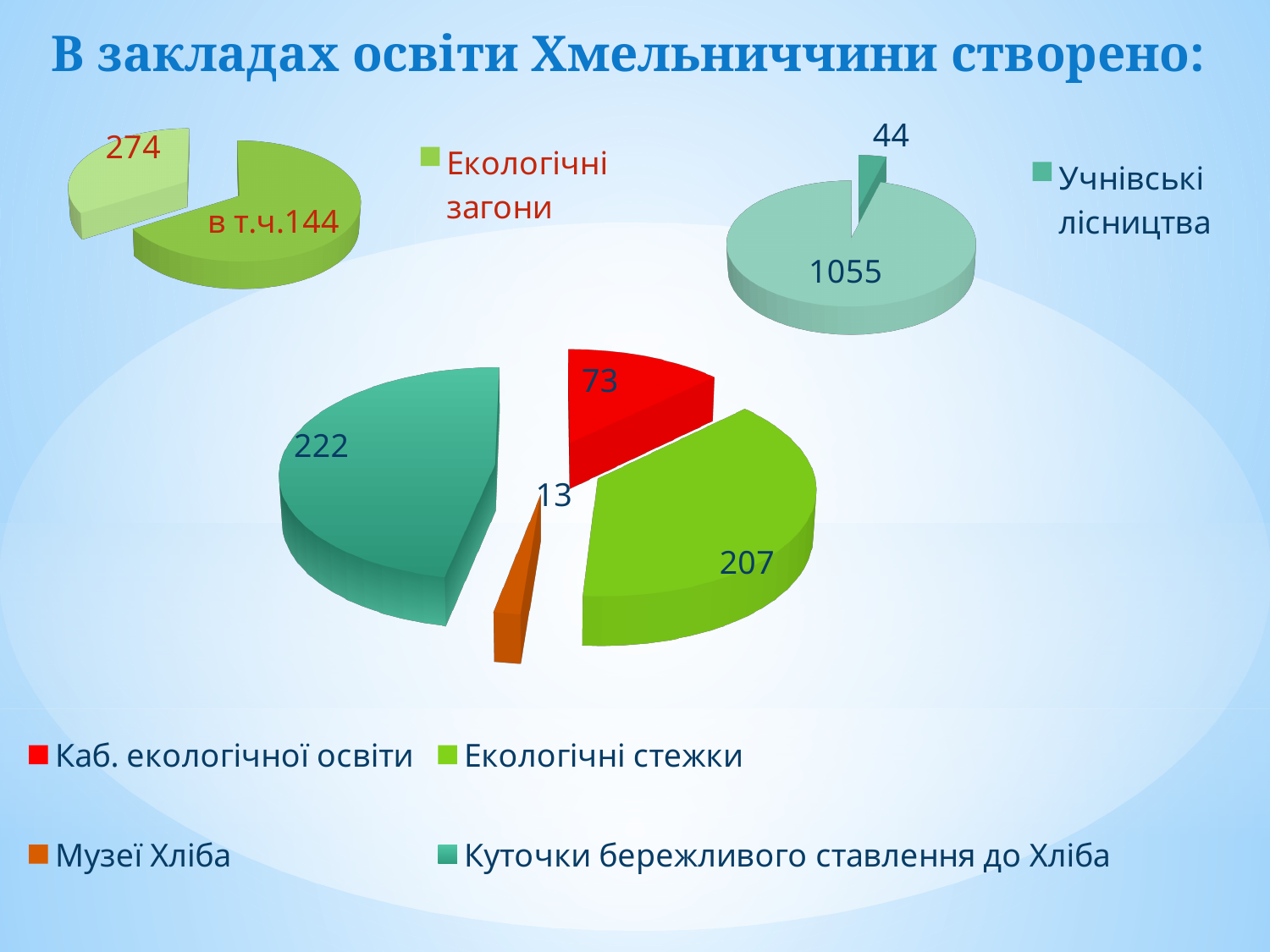
On the bottom pie chart, what is the difference between Куточки бережливого ставлення до Хліба and Екологічні стежки? 15 On the top-right pie chart (Учнівські лісництва), what is the value of the large slice? 1055 On the bottom pie chart, which category has the smallest value? Музеї Хліба On the bottom pie chart, which category has the largest value? Куточки бережливого ставлення до Хліба What kind of chart is the top-left chart (Екологічні загони)? pie chart On the bottom pie chart, how many slices are there? 4 On the bottom pie chart, what is the value for Куточки бережливого ставлення до Хліба? 222 On the bottom pie chart, which is larger: Каб. екологічної освіти or Екологічні стежки? Екологічні стежки On the bottom pie chart, what is the total of all four slices? 515 On the bottom pie chart, what is the value for Каб. екологічної освіти? 73 On the bottom pie chart, what is the value for Екологічні стежки? 207 On the bottom pie chart, what is the value for Музеї Хліба? 13